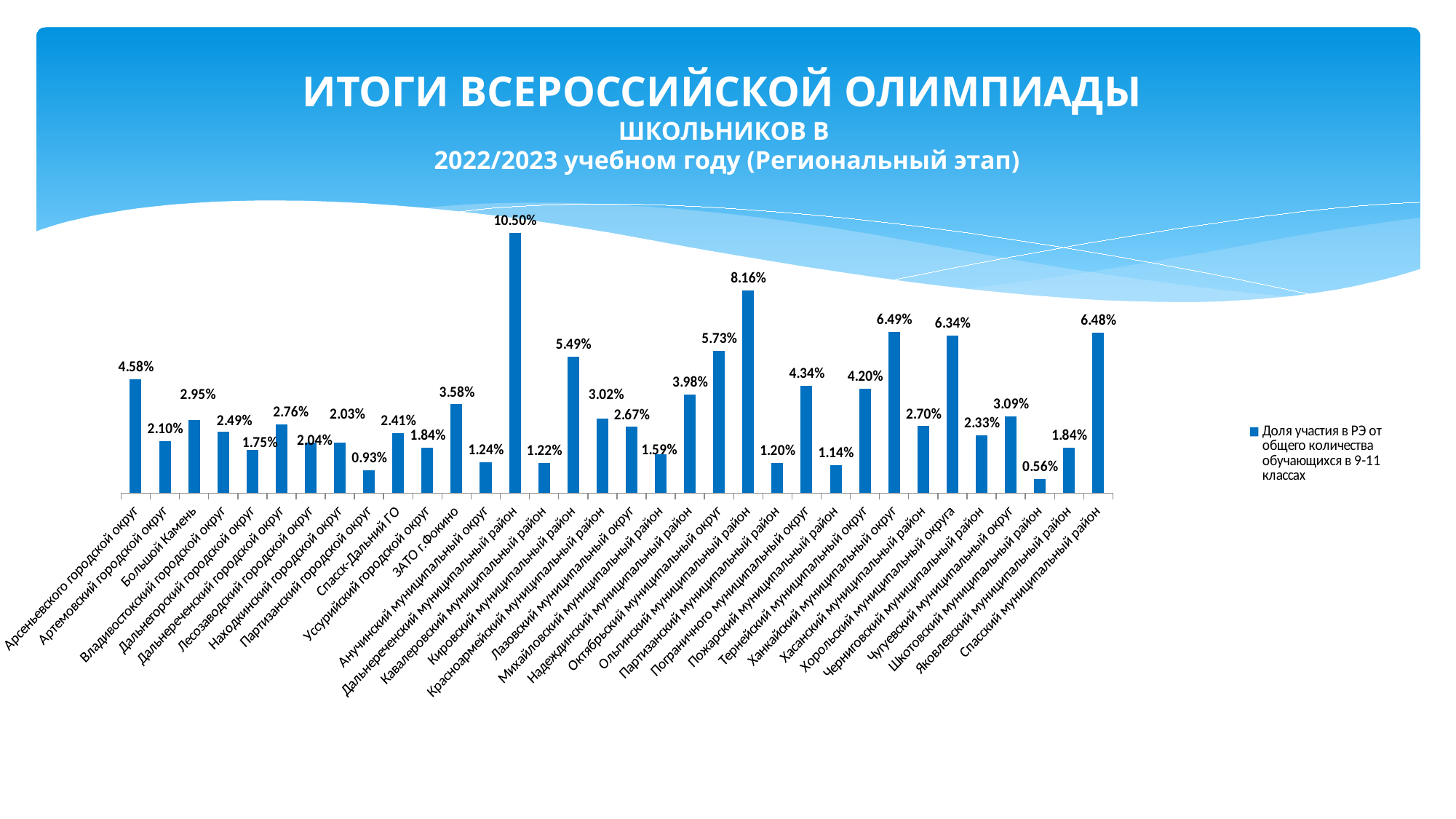
What is the value for Шкотовский муниципальный район? 0.56% Which category has the highest value? Дальнереченский муниципальный район What is the legend entry for the series? Доля участия в РЭ от общего количества обучающихся в 9-11 классах How many categories are shown on the x axis? 34 What kind of chart is shown on the slide? Bar chart What is the value for Ольгинский муниципальный район? 8.16% What is the value for Дальнереченский муниципальный район? 10.50% What is the difference between the values for Дальнереченский муниципальный район and Ольгинский муниципальный район? 2.34% Which is larger, the value for Кировский муниципальный район or the value for Надеждинский муниципальный район? Кировский муниципальный район What is the value for Арсеньевского городской округ? 4.58% How many series does the legend list? 1 Which category has the lowest value? Шкотовский муниципальный район